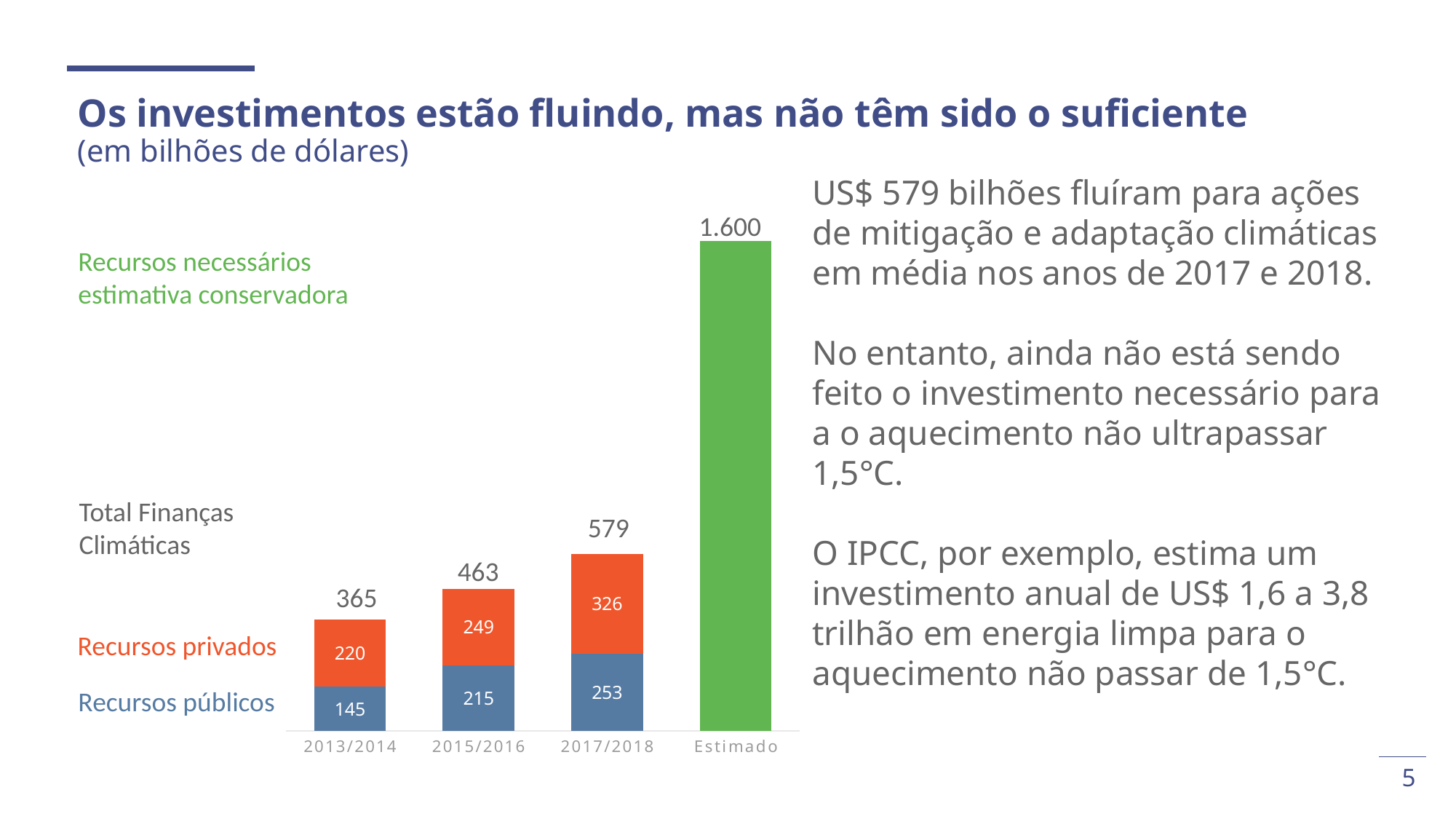
Which category has the highest bar? Estimado What is the total shown above the 2015/2016 bar? 463 What is the total of the 2017/2018 stacked bar? 579 Which of the three stacked bars (2013/2014, 2015/2016, 2017/2018) has the lowest total? 2013/2014 Do the Total Finanças Climáticas values rise or fall from 2013/2014 to 2017/2018? Rise How many categories are shown on the x axis? 4 What is the value of the Estimado bar? 1.600 What is the value of Recursos públicos for 2013/2014? 145 What kind of chart is shown on the slide? Stacked bar chart Which is larger: Recursos públicos in 2017/2018 or Recursos privados in 2013/2014? Recursos públicos in 2017/2018 What is the value of Recursos privados for 2017/2018? 326 What is the difference between the Recursos privados values for 2015/2016 and 2013/2014? 29